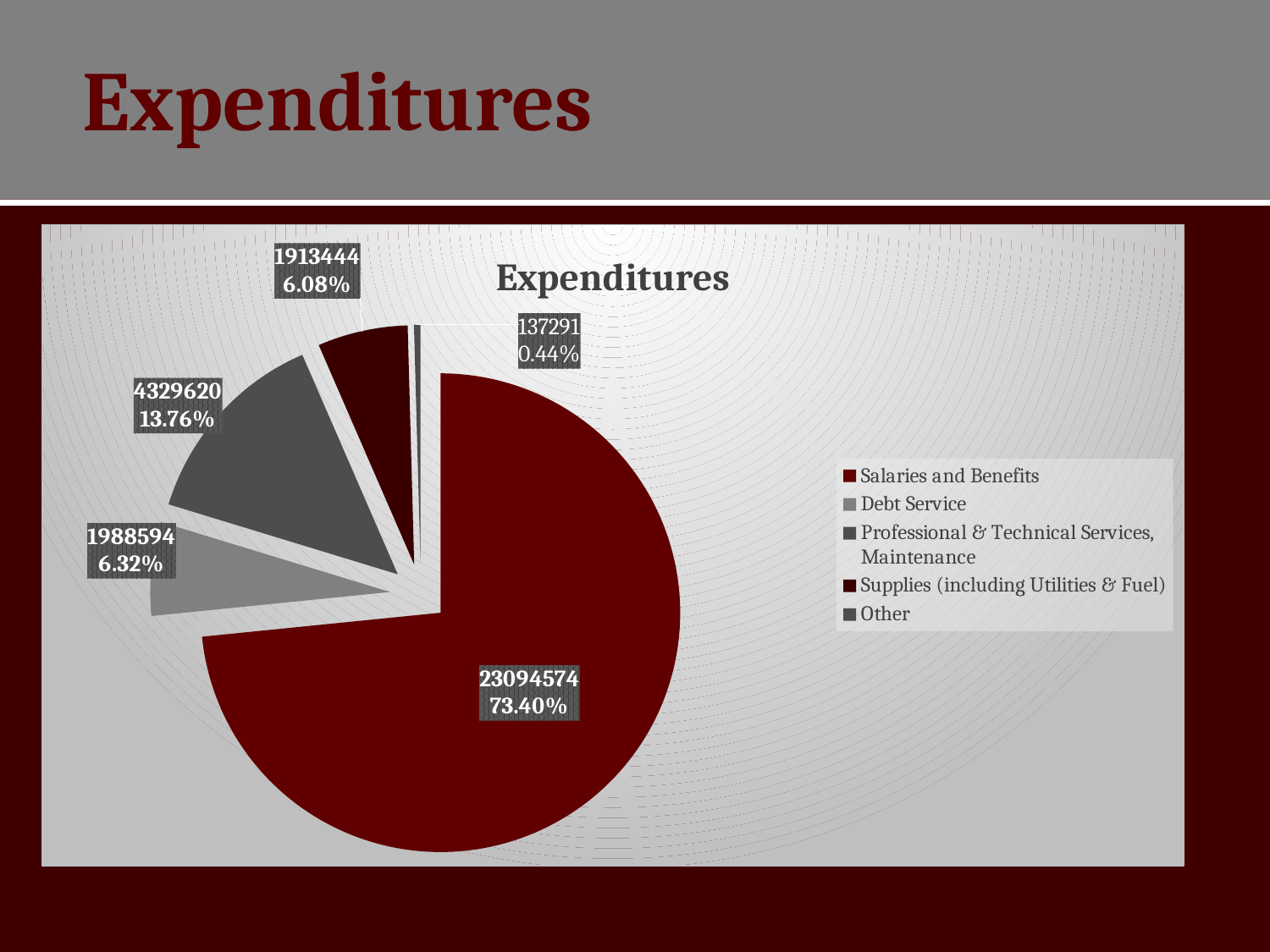
What is the value for Salaries and Benefits? 23094574 How many categories does the legend list? 5 What share of the pie is Debt Service? 6.32% Which is larger, Debt Service or Supplies (including Utilities & Fuel)? Debt Service What is the value for Professional & Technical Services, Maintenance? 4329620 Which category has the largest slice? Salaries and Benefits What share of the pie is Other? 0.44% What kind of chart is shown on the slide? pie chart What is the title of the chart? Expenditures What share of the pie is Salaries and Benefits? 73.40% Which category has the smallest slice? Other What is the value for Supplies (including Utilities & Fuel)? 1913444